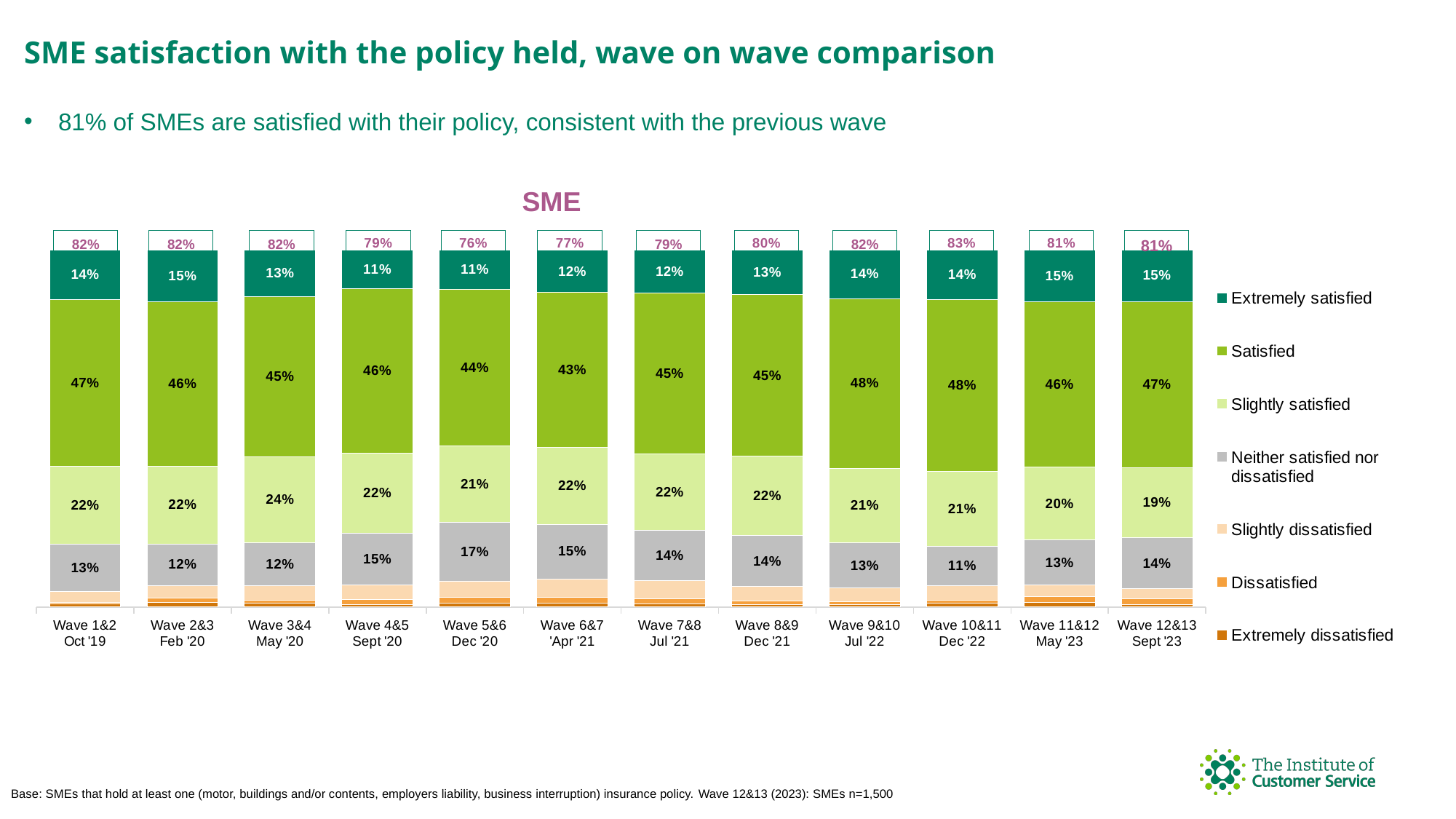
What is the Neither satisfied nor dissatisfied value for Wave 5&6 Dec '20? 17% Which wave has the highest Satisfied value? Wave 9&10 Jul '22 and Wave 10&11 Dec '22 (48%) What is the combined satisfaction percentage shown above the bar for Wave 10&11 Dec '22? 83% How many waves (categories) are shown along the x axis? 12 What kind of chart is shown on the slide? Stacked bar chart What is the Extremely satisfied value for Wave 4&5 Sept '20? 11% Which wave has the lowest combined satisfaction percentage shown above the bars? Wave 5&6 Dec '20 (76%) What is the title of the chart? SME How many series does the legend list? 7 Which is larger, the Neither satisfied nor dissatisfied value for Wave 6&7 'Apr '21 or for Wave 10&11 Dec '22? Wave 6&7 'Apr '21 What is the difference between the Slightly satisfied values for Wave 3&4 May '20 and Wave 12&13 Sept '23? 5 percentage points What is the Satisfied value for Wave 12&13 Sept '23? 47%